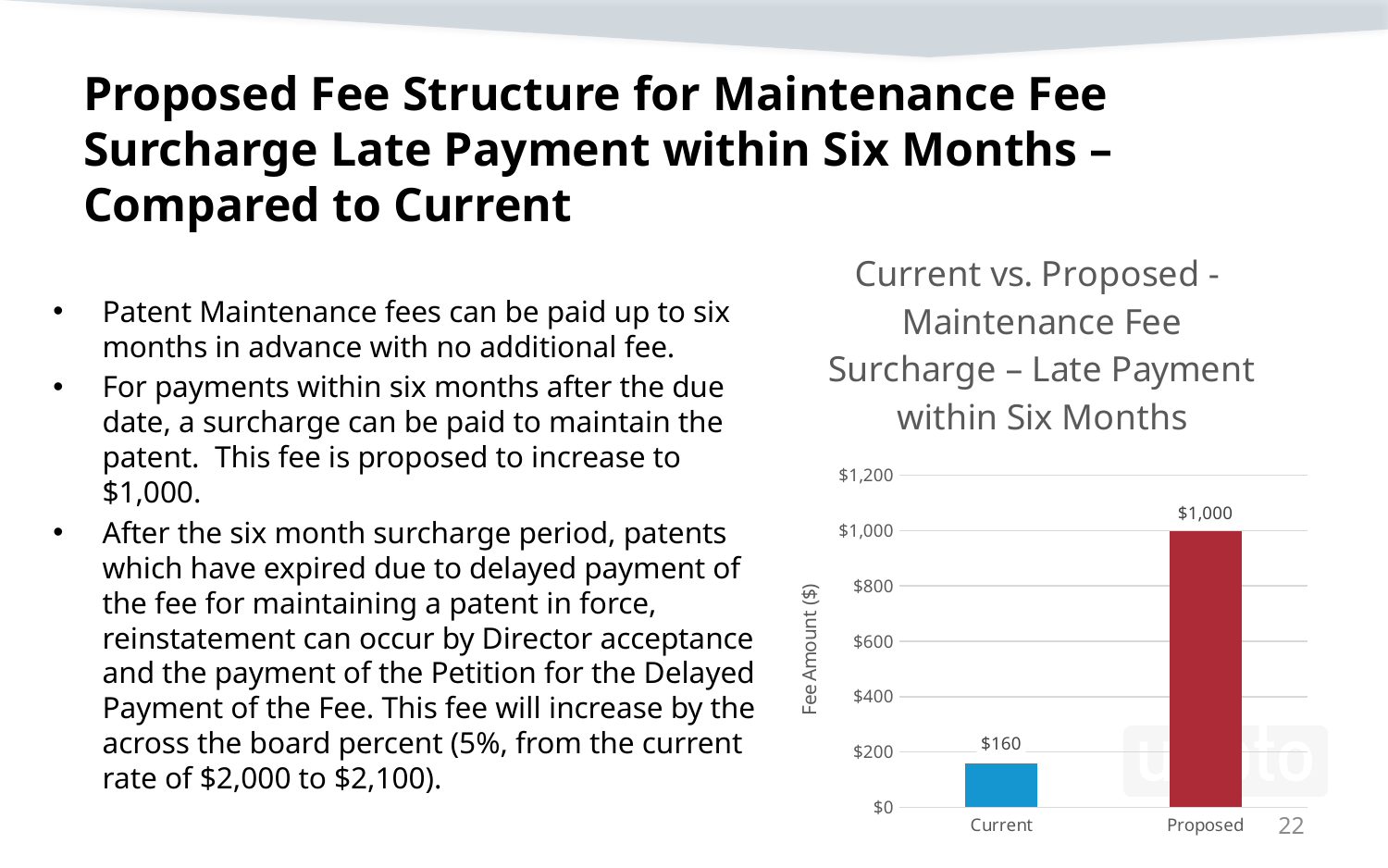
Is the value for Proposed greater or less than $800? greater What is the label of the vertical axis? Fee Amount ($) How many categories are shown on the x axis? 2 What kind of chart is shown on the slide? Bar chart What is the fee amount for Proposed? $1,000 What is the fee amount for Current? $160 Which category has the lowest fee amount? Current Which category has the highest fee amount? Proposed What is the title of the chart? Current vs. Proposed - Maintenance Fee Surcharge – Late Payment within Six Months Which is larger, the Current fee or the Proposed fee? Proposed What is the difference between the Proposed and Current fee amounts? $840 Is the value for Current greater or less than $200? less